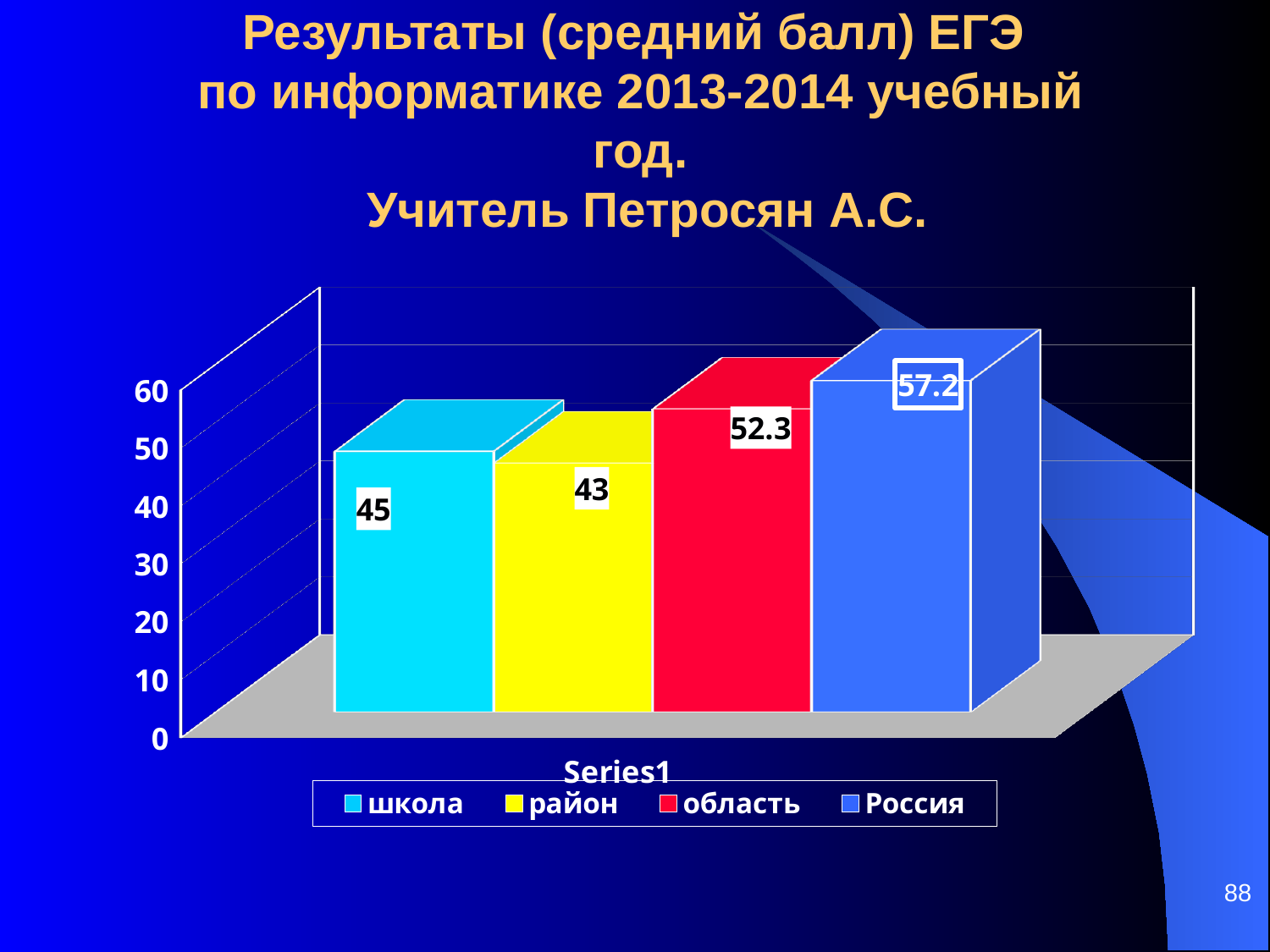
Which is larger, the value for область or the value for школа? область What is the value for район? 43 What is the difference between the values for Россия and школа? 12.2 What kind of chart is shown on the slide? bar chart What is the value for Россия? 57.2 Which category has the highest value? Россия What is the value for школа? 45 How many entries does the legend list? 4 Which category has the lowest value? район What is the value for область? 52.3 How many bars are shown in the chart? 4 What is the difference between the values for область and район? 9.3